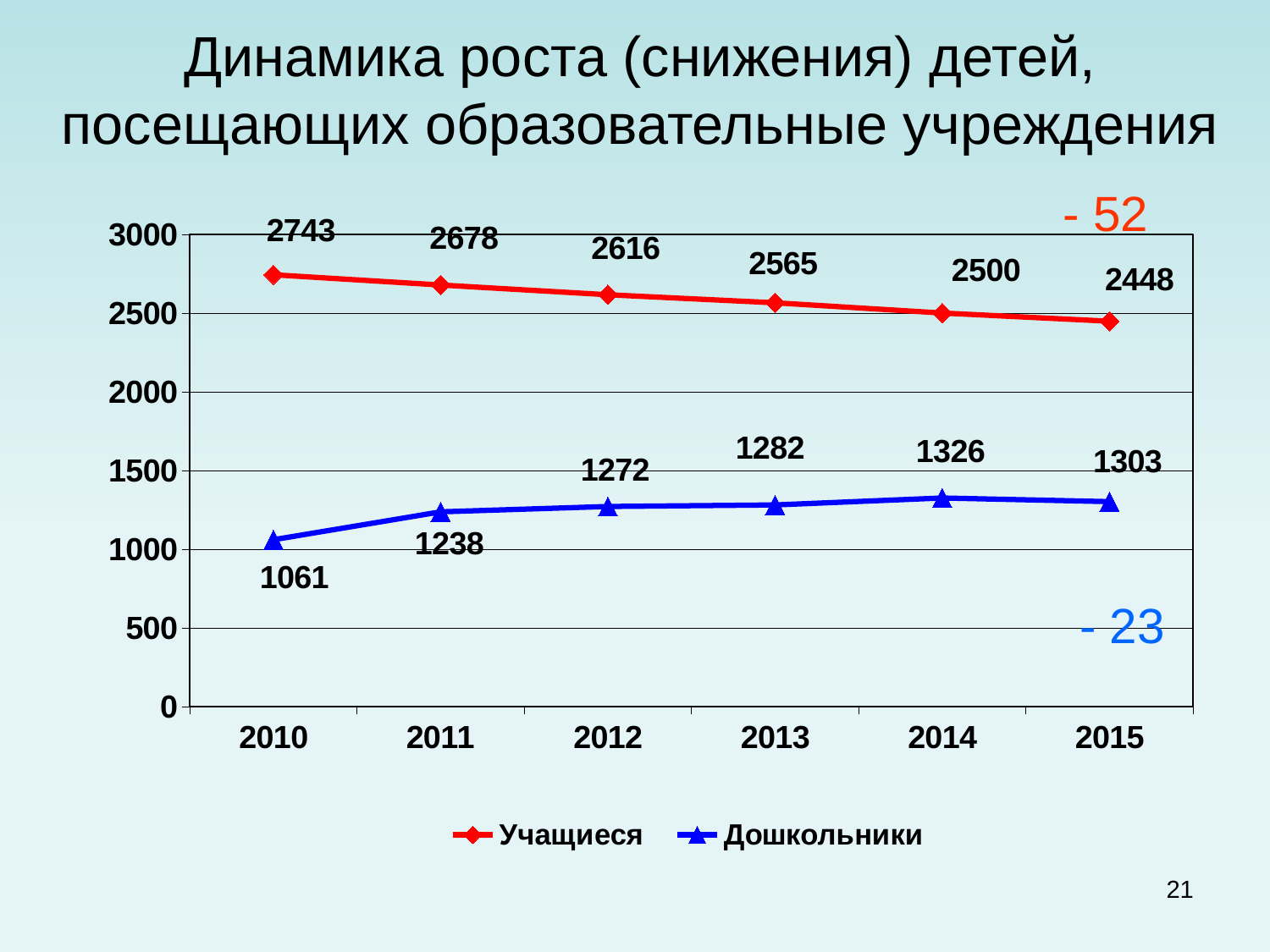
In which year is the value for Учащиеся the highest? 2010 How many years are shown on the x axis? 6 What kind of chart is shown on the slide? line chart In which year is the value for Дошкольники the lowest? 2010 What is the value for Дошкольники in 2014? 1326 How many series does the legend list? 2 Is the value for Дошкольники in 2012 greater or less than 1500? less What is the value for Учащиеся in 2015? 2448 What is the difference between the Учащиеся values in 2014 and 2015? 52 What is the difference between the Дошкольники values in 2014 and 2015? 23 Which is larger in 2013: the value for Учащиеся or for Дошкольники? Учащиеся What is the value for Учащиеся in 2010? 2743